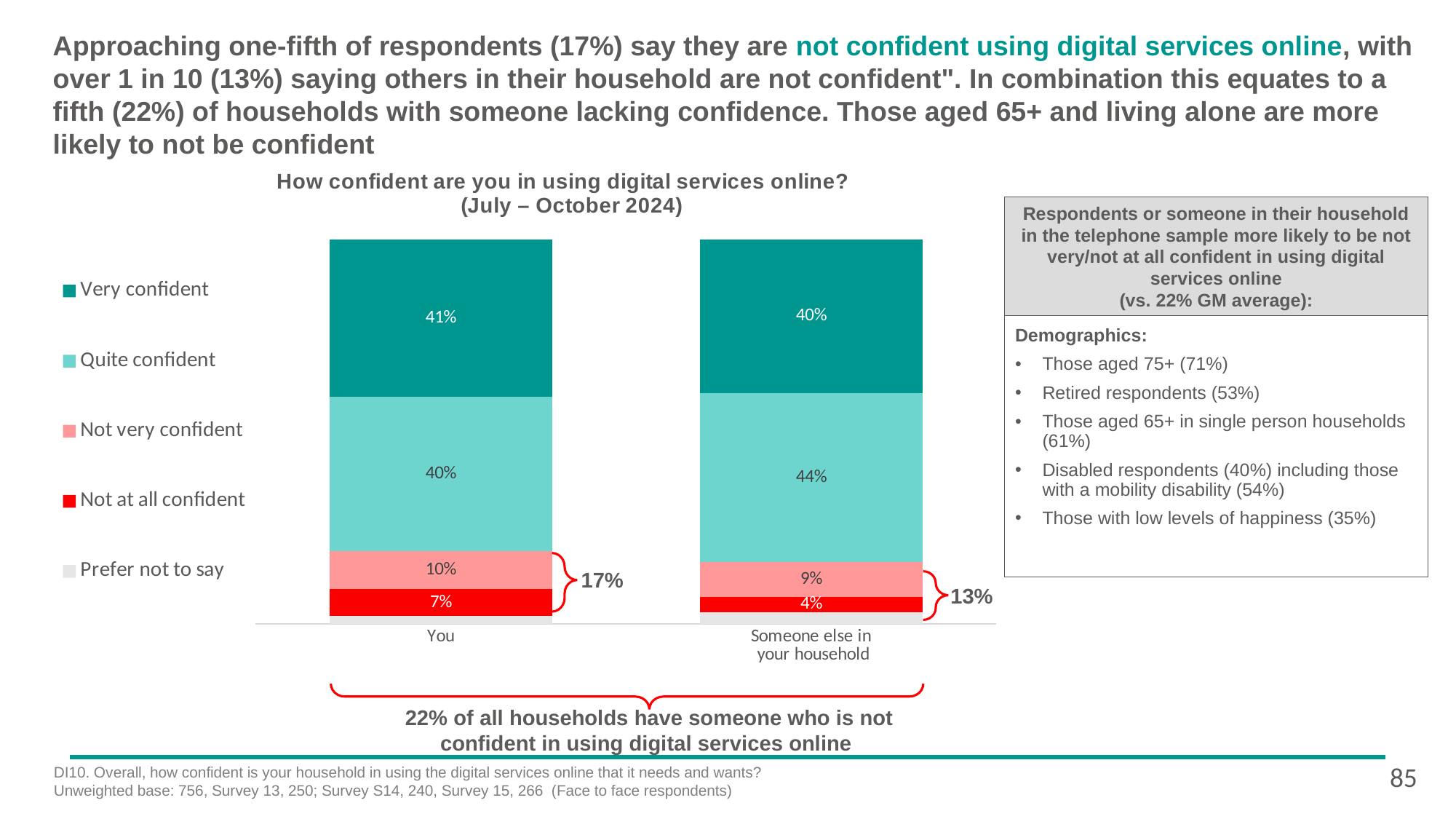
What is the difference between the 'Quite confident' values for 'Someone else in your household' and 'You'? 4% How many categories are shown on the x axis? 2 What is the 'Quite confident' value for 'Someone else in your household'? 44% What is the 'Very confident' value for 'You'? 41% What is the 'Not at all confident' value for 'You'? 7% Which category has the larger 'Not at all confident' value, 'You' or 'Someone else in your household'? You What is the combined 'Not very confident' and 'Not at all confident' share for 'Someone else in your household', as labelled by the brace? 13% What is the title of the chart? How confident are you in using digital services online? (July – October 2024) What kind of chart is shown on the slide? Stacked bar chart What is the combined 'Not very confident' and 'Not at all confident' share for 'You', as labelled by the brace? 17% How many series does the legend list? 5 What is the 'Not very confident' value for 'Someone else in your household'? 9%